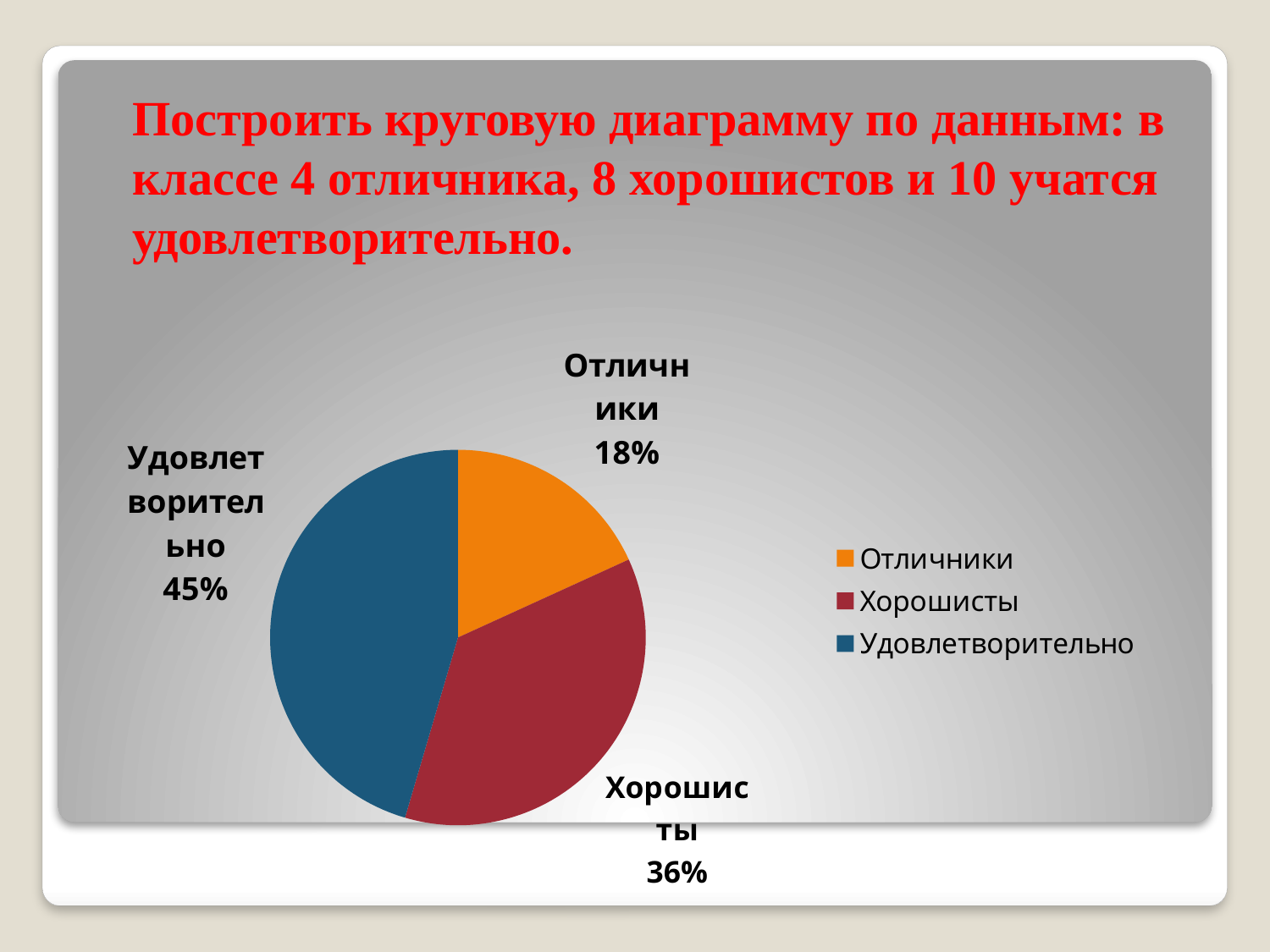
How many slices does the pie chart have? 3 What is the difference in percentage points between Удовлетворительно and Отличники? 27% Which category has the smallest slice of the pie? Отличники What share of the pie does Хорошисты have? 36% What share of the pie does Удовлетворительно have? 45% Which is larger, the slice for Хорошисты or the slice for Отличники? Хорошисты What colour is the slice for Удовлетворительно? blue How many entries does the legend list? 3 What share of the pie does Отличники have? 18% Which category has the largest slice of the pie? Удовлетворительно What kind of chart is shown on the slide? pie chart What is the difference in percentage points between Хорошисты and Отличники? 18%